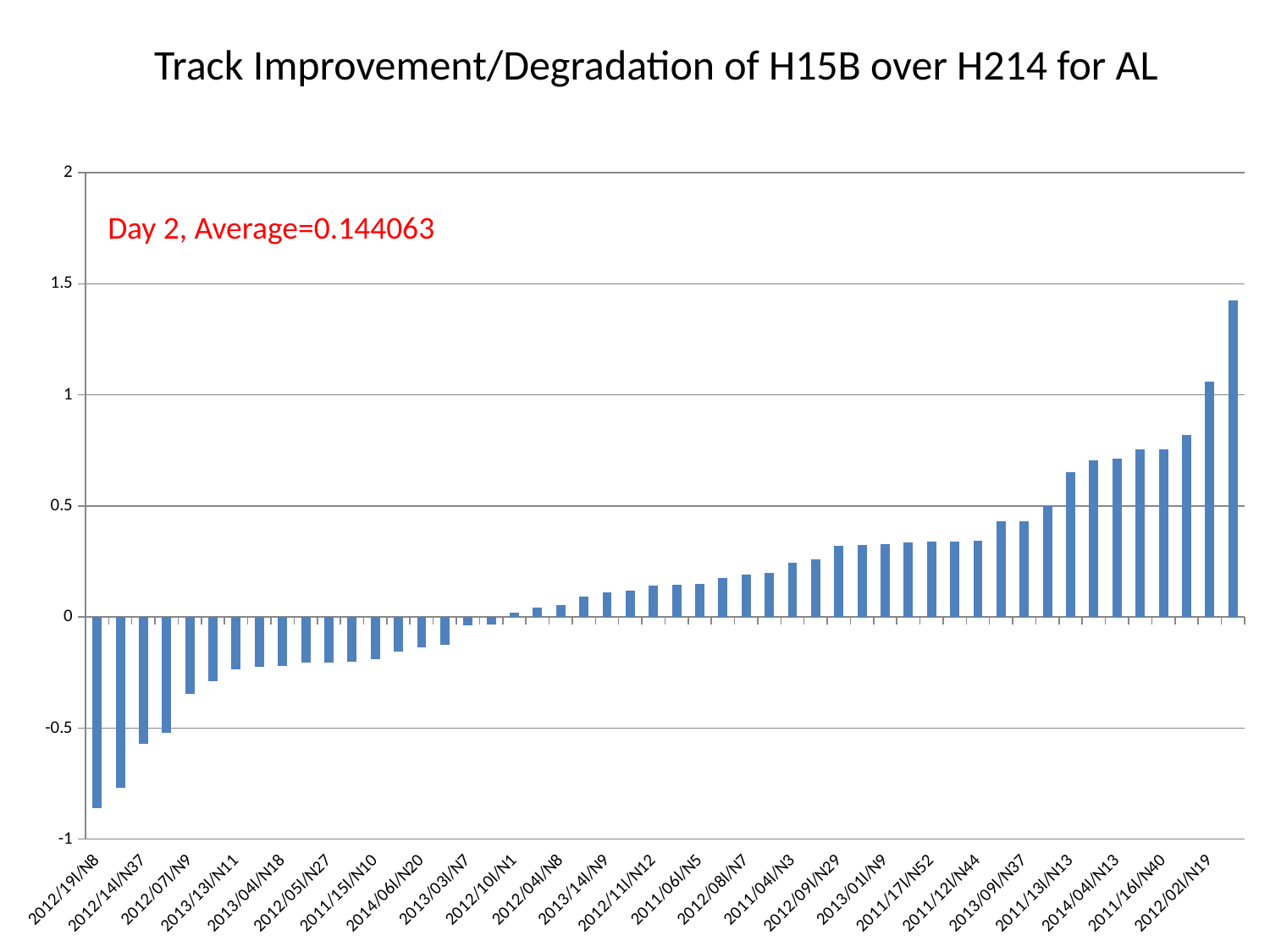
Which has the larger value, 2012/02I/N19 or 2012/19I/N8? 2012/02I/N19 Do the bar values rise or fall from left to right along the x axis? rise Which labeled category has the lowest value? 2012/19I/N8 What average value is stated in the red annotation on the chart? 0.144063 Is the value for 2011/16I/N40 greater or less than 1? less Is the value for 2013/09I/N37 greater or less than 0.5? less What is the title of the chart? Track Improvement/Degradation of H15B over H214 for AL Is the value for 2011/16I/N40 greater or less than 0.5? greater What type of chart is shown on the slide? bar chart Which has the larger value, 2012/07I/N9 or 2013/13I/N11? 2013/13I/N11